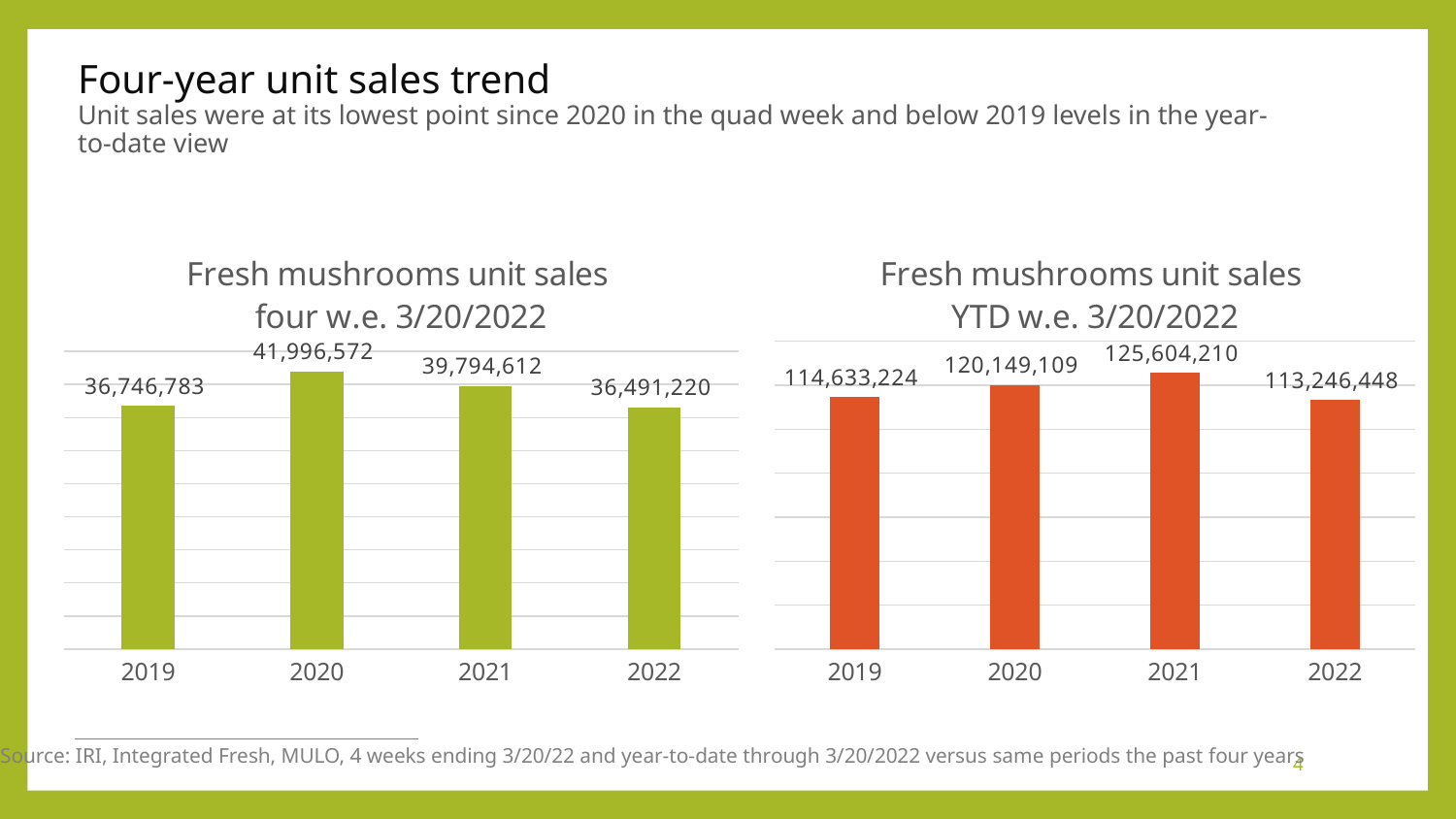
In the 'Fresh mushrooms unit sales YTD w.e. 3/20/2022' chart, which year has the highest value? 2021 What colour are the bars in the 'Fresh mushrooms unit sales four w.e. 3/20/2022' chart? Green In the 'Fresh mushrooms unit sales four w.e. 3/20/2022' chart, what is the difference between the 2020 and 2022 values? 5,505,352 In the 'Fresh mushrooms unit sales four w.e. 3/20/2022' chart, which is larger, the value for 2021 or the value for 2022? 2021 In the 'Fresh mushrooms unit sales YTD w.e. 3/20/2022' chart, what is the difference between the 2021 and 2022 values? 12,357,762 How many years are shown on the x axis of the 'Fresh mushrooms unit sales four w.e. 3/20/2022' chart? 4 In the 'Fresh mushrooms unit sales YTD w.e. 3/20/2022' chart, what is the value for 2022? 113,246,448 In the 'Fresh mushrooms unit sales four w.e. 3/20/2022' chart, what is the value for 2020? 41,996,572 In the 'Fresh mushrooms unit sales YTD w.e. 3/20/2022' chart, which is larger, the value for 2019 or the value for 2020? 2020 In the 'Fresh mushrooms unit sales YTD w.e. 3/20/2022' chart, which year has the lowest value? 2022 What kind of chart is the 'Fresh mushrooms unit sales YTD w.e. 3/20/2022' chart? Bar chart In the 'Fresh mushrooms unit sales four w.e. 3/20/2022' chart, which year has the highest value? 2020